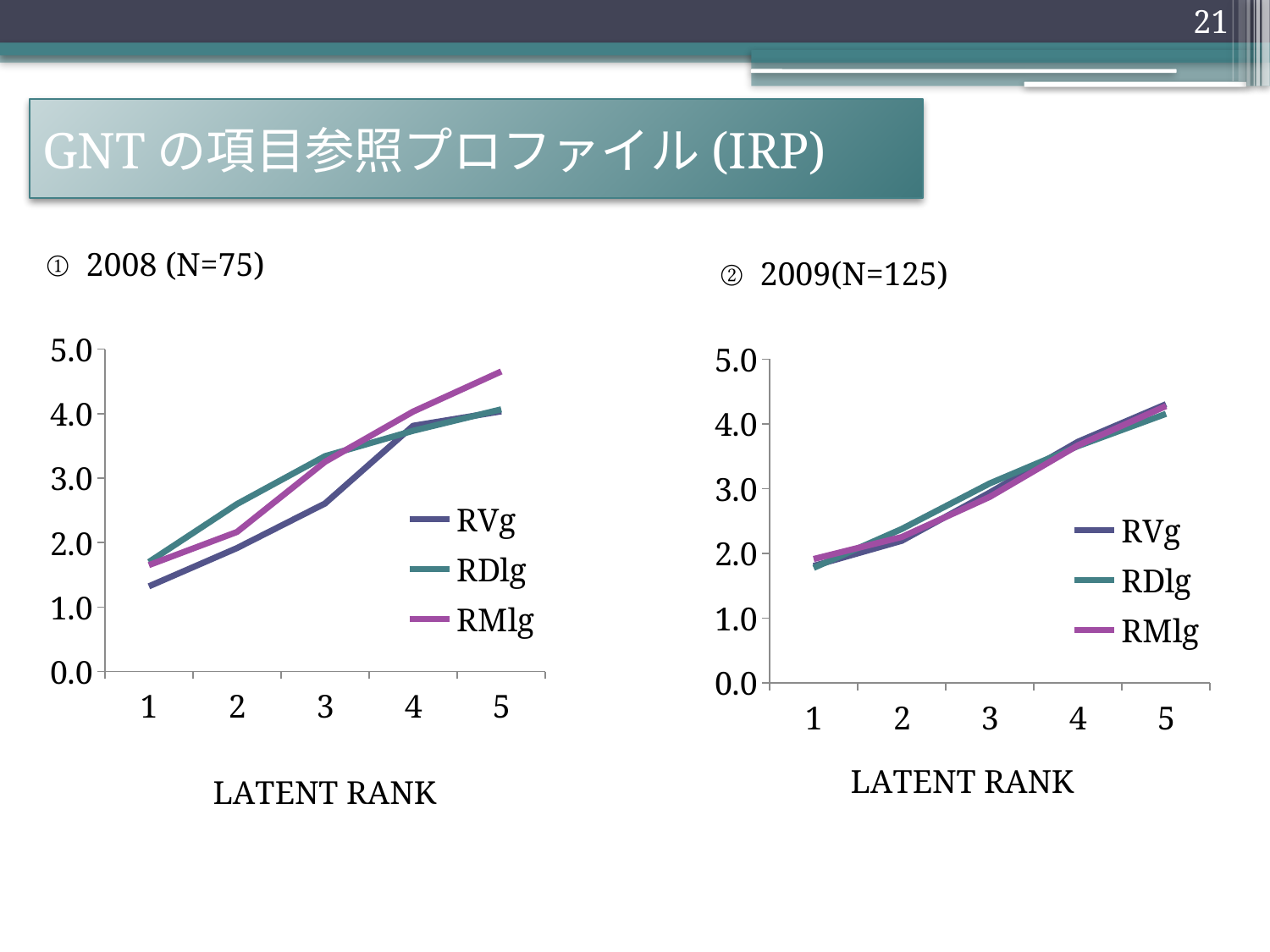
In the 2009 (N=125) chart, is the RVg value at latent rank 1 greater or less than 3.0? less In the 2008 (N=75) chart, is the RVg value at latent rank 1 greater or less than 2.0? less In the 2008 (N=75) chart, which series has the lowest value at latent rank 1? RVg In the 2008 (N=75) chart, is the RMlg value at latent rank 5 greater or less than 4.0? greater How many series does the legend of the 2009 (N=125) chart list? 3 In the 2008 (N=75) chart, do the RVg values rise or fall as latent rank increases from 1 to 5? rise In the 2009 (N=125) chart, do the RMlg values rise or fall as latent rank increases from 1 to 5? rise How many latent rank points are plotted along the x axis of the 2008 (N=75) chart? 5 What kind of chart is the 2008 (N=75) chart on the left? line chart In the 2008 (N=75) chart, which series has the highest value at latent rank 5? RMlg In the 2008 (N=75) chart, at latent rank 3, which is larger: RDlg or RVg? RDlg